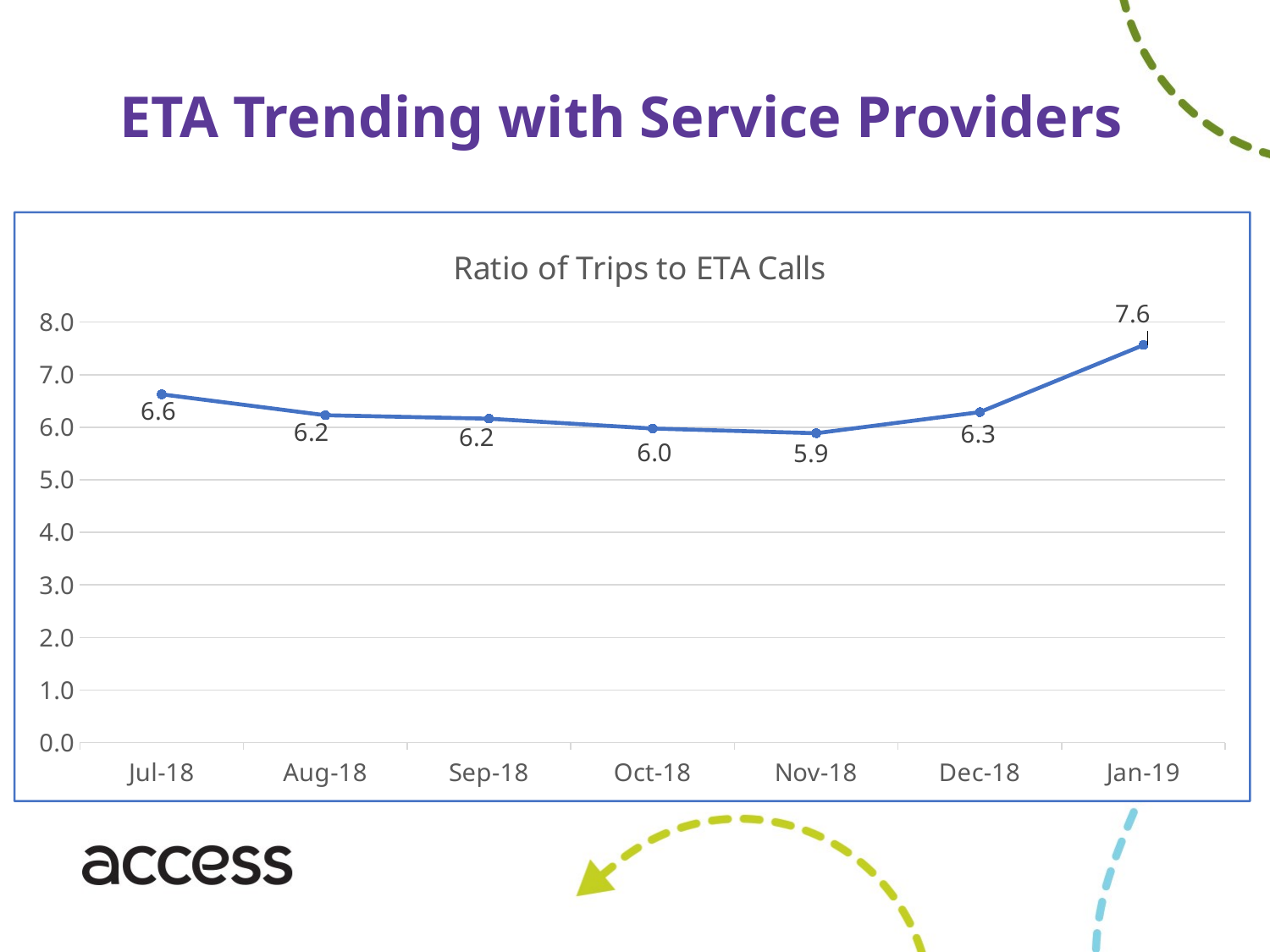
What is the ratio of trips to ETA calls for Dec-18? 6.3 What is the title of the chart? Ratio of Trips to ETA Calls How many months are plotted on the chart? 7 Is the value for Jan-19 greater or less than 7.0? greater What is the ratio of trips to ETA calls for Jul-18? 6.6 Which is larger, the ratio for Jul-18 or the ratio for Dec-18? Jul-18 What kind of chart is shown on the slide? Line chart What is the ratio of trips to ETA calls for Nov-18? 5.9 What is the ratio of trips to ETA calls for Jan-19? 7.6 Which month has the lowest ratio of trips to ETA calls? Nov-18 What is the difference between the ratio for Jan-19 and the ratio for Nov-18? 1.7 Which month has the highest ratio of trips to ETA calls? Jan-19